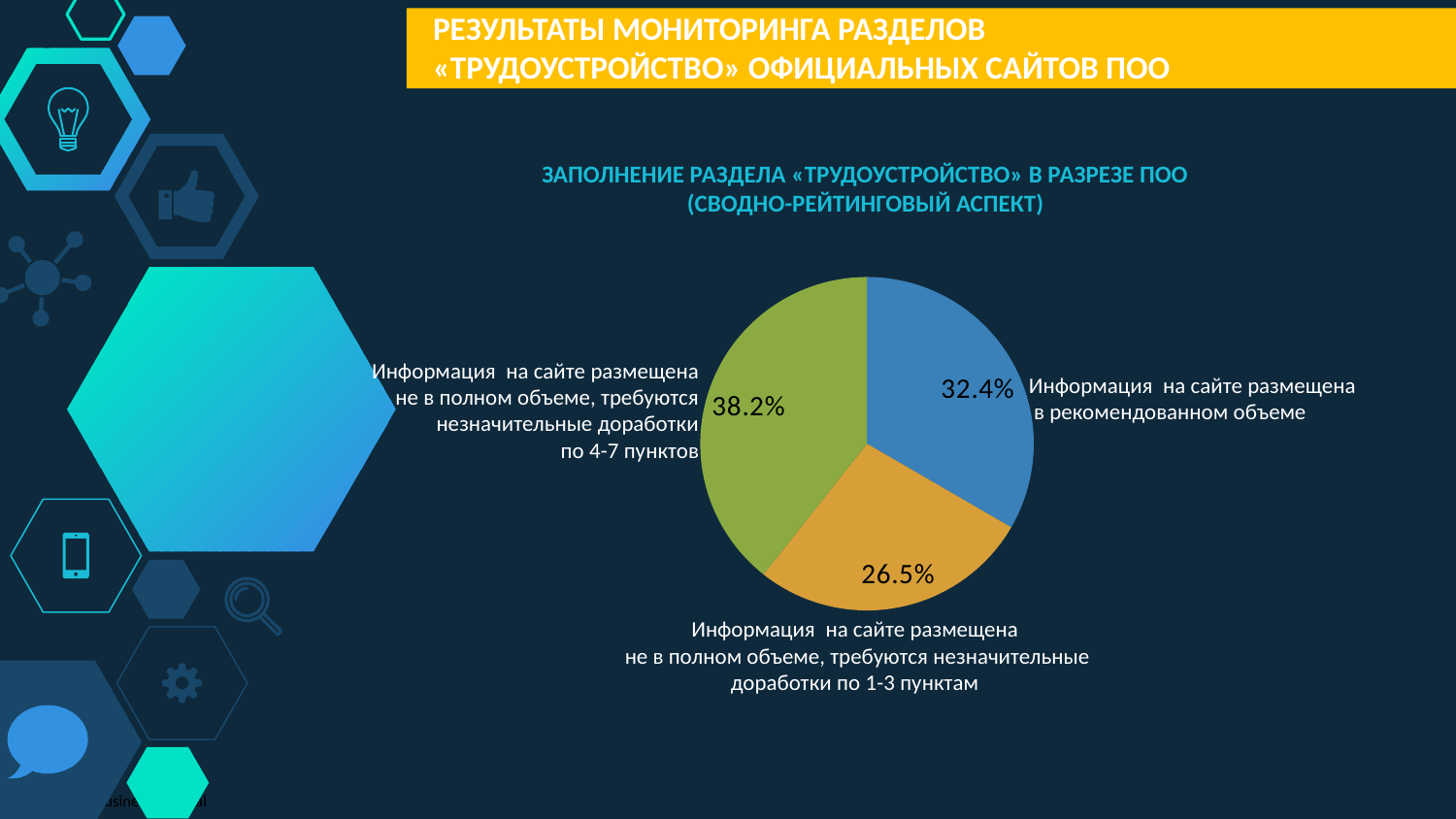
What share of the pie is labelled "Информация на сайте размещена в рекомендованном объеме"? 32.4% What is the difference in percentage points between the 32.4% slice and the 26.5% slice? 5.9 Which category has the largest share of the pie? Информация на сайте размещена не в полном объеме, требуются незначительные доработки по 4-7 пунктов What colour is the slice representing 26.5%? Orange Which category has the smallest share of the pie? Информация на сайте размещена не в полном объеме, требуются незначительные доработки по 1-3 пунктам What share of the pie is labelled "Информация на сайте размещена не в полном объеме, требуются незначительные доработки по 1-3 пунктам"? 26.5% What is the title of the chart? ЗАПОЛНЕНИЕ РАЗДЕЛА «ТРУДОУСТРОЙСТВО» В РАЗРЕЗЕ ПОО (СВОДНО-РЕЙТИНГОВЫЙ АСПЕКТ) What share of the pie is labelled "Информация на сайте размещена не в полном объеме, требуются незначительные доработки по 4-7 пунктов"? 38.2% How many slices does the pie chart have? 3 Which is larger: the share for sites with information in the recommended volume (в рекомендованном объеме) or the share for sites needing revisions on 1-3 points (по 1-3 пунктам)? в рекомендованном объеме (32.4%) What is the difference in percentage points between the 38.2% slice and the 26.5% slice? 11.7 What type of chart is shown on the slide? Pie chart